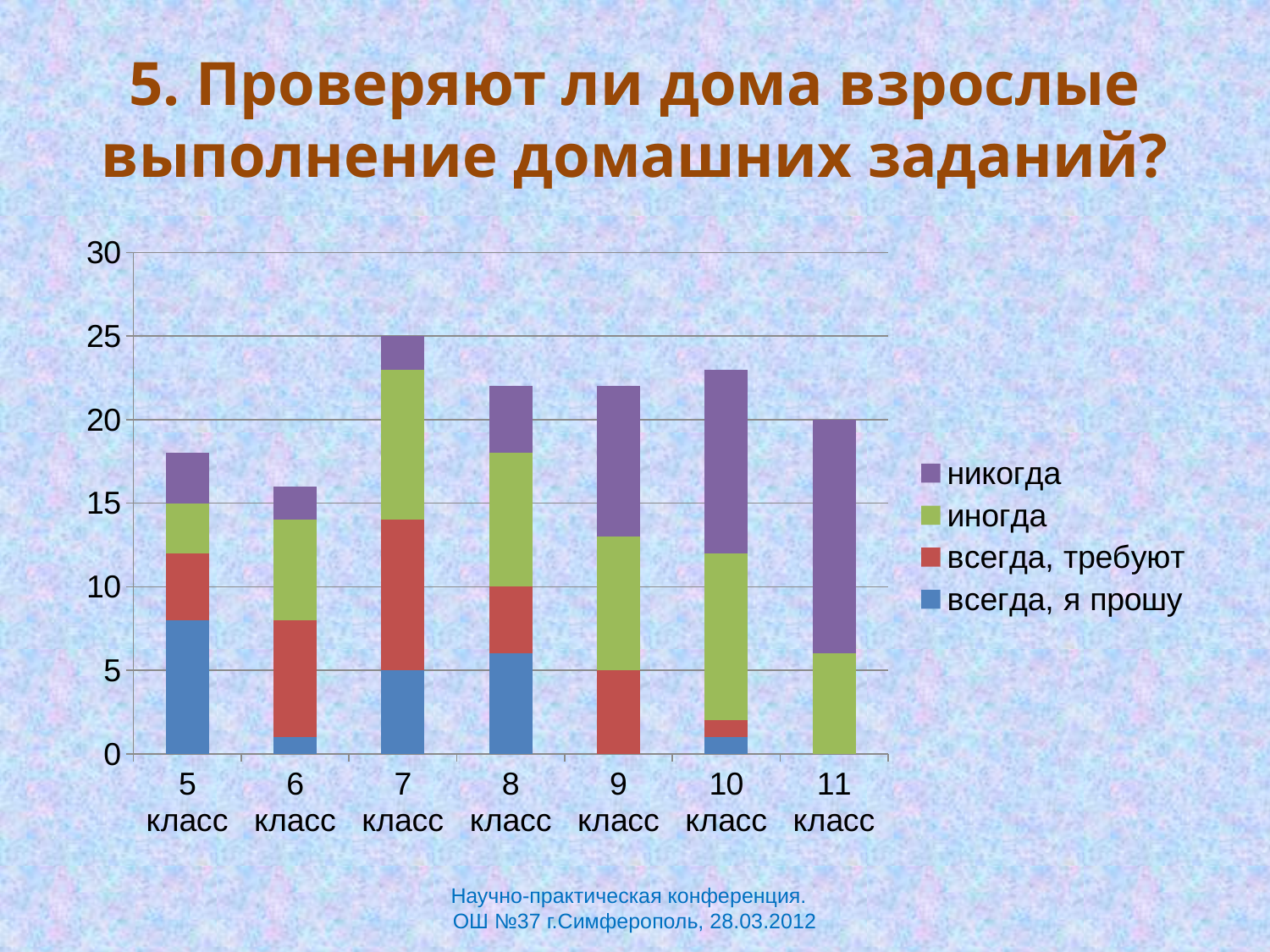
What kind of chart is shown on the slide? stacked bar chart What is the total height of the stacked bar for 7 класс? 25 Which class has the tallest stacked bar? 7 класс How many classes (categories) are shown on the x axis? 7 Is the total for 5 класс greater or less than 15? greater Is the total for 10 класс greater or less than 20? greater Which series is shown in purple in the legend? никогда Which class has the shortest stacked bar? 6 класс Which stacked bar is taller, 6 класс or 8 класс? 8 класс Which series is shown in blue in the legend? всегда, я прошу What is the total height of the stacked bar for 11 класс? 20 How many series does the legend list? 4